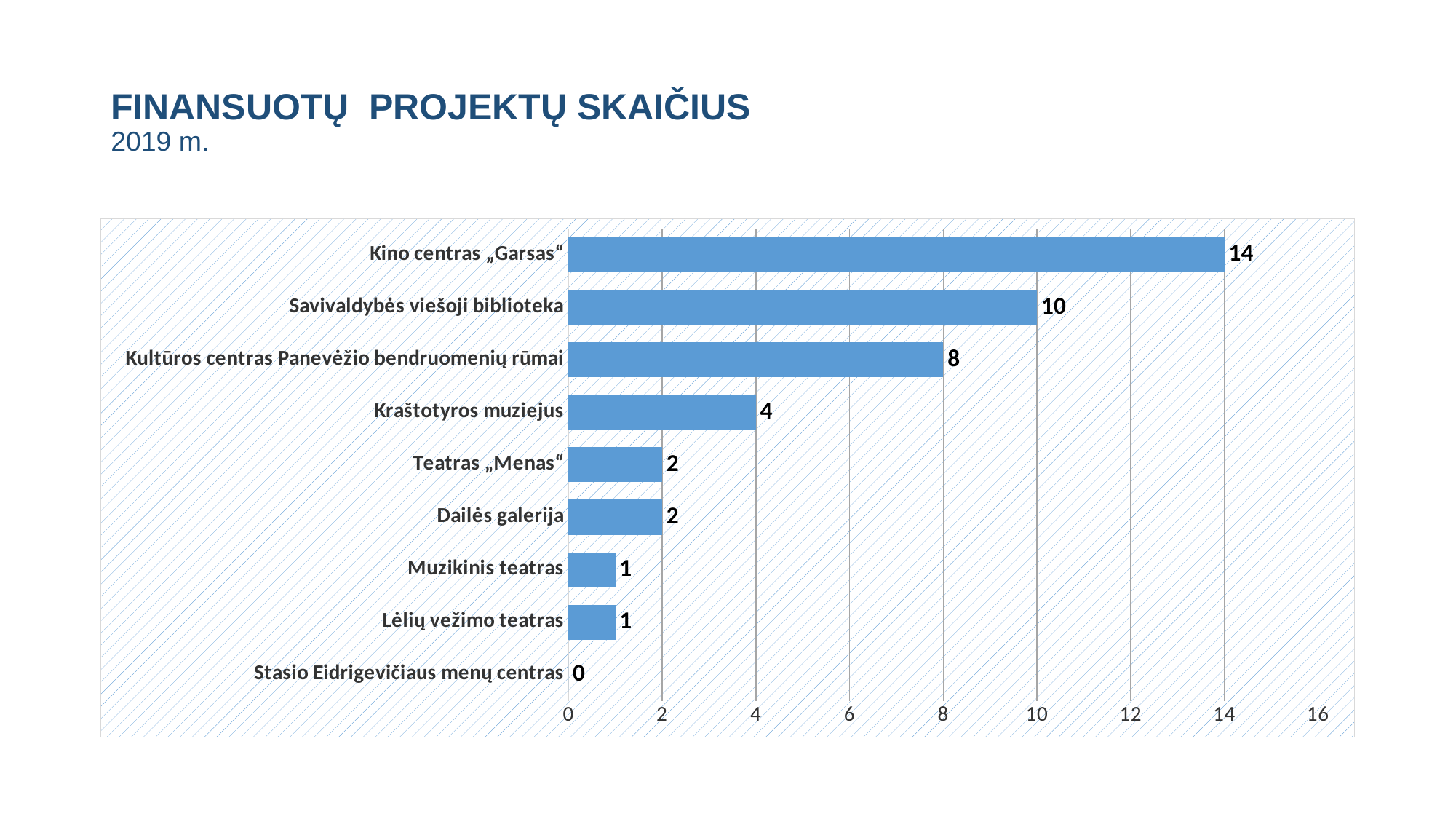
How many categories are shown in the chart? 9 How many funded projects does Kino centras „Garsas“ have? 14 What is the difference between the values for Kino centras „Garsas“ and Savivaldybės viešoji biblioteka? 4 Which category has the highest number of funded projects? Kino centras „Garsas“ Which category has the lowest number of funded projects? Stasio Eidrigevičiaus menų centras Which is larger, the value for Kraštotyros muziejus or the value for Teatras „Menas“? Kraštotyros muziejus What is the value for Savivaldybės viešoji biblioteka? 10 What kind of chart is shown on the slide? Bar chart What is the title of the chart on the slide? FINANSUOTŲ PROJEKTŲ SKAIČIUS 2019 m. What is the value for Kultūros centras Panevėžio bendruomenių rūmai? 8 What is the value for Stasio Eidrigevičiaus menų centras? 0 What is the difference between the values for Kultūros centras Panevėžio bendruomenių rūmai and Kraštotyros muziejus? 4